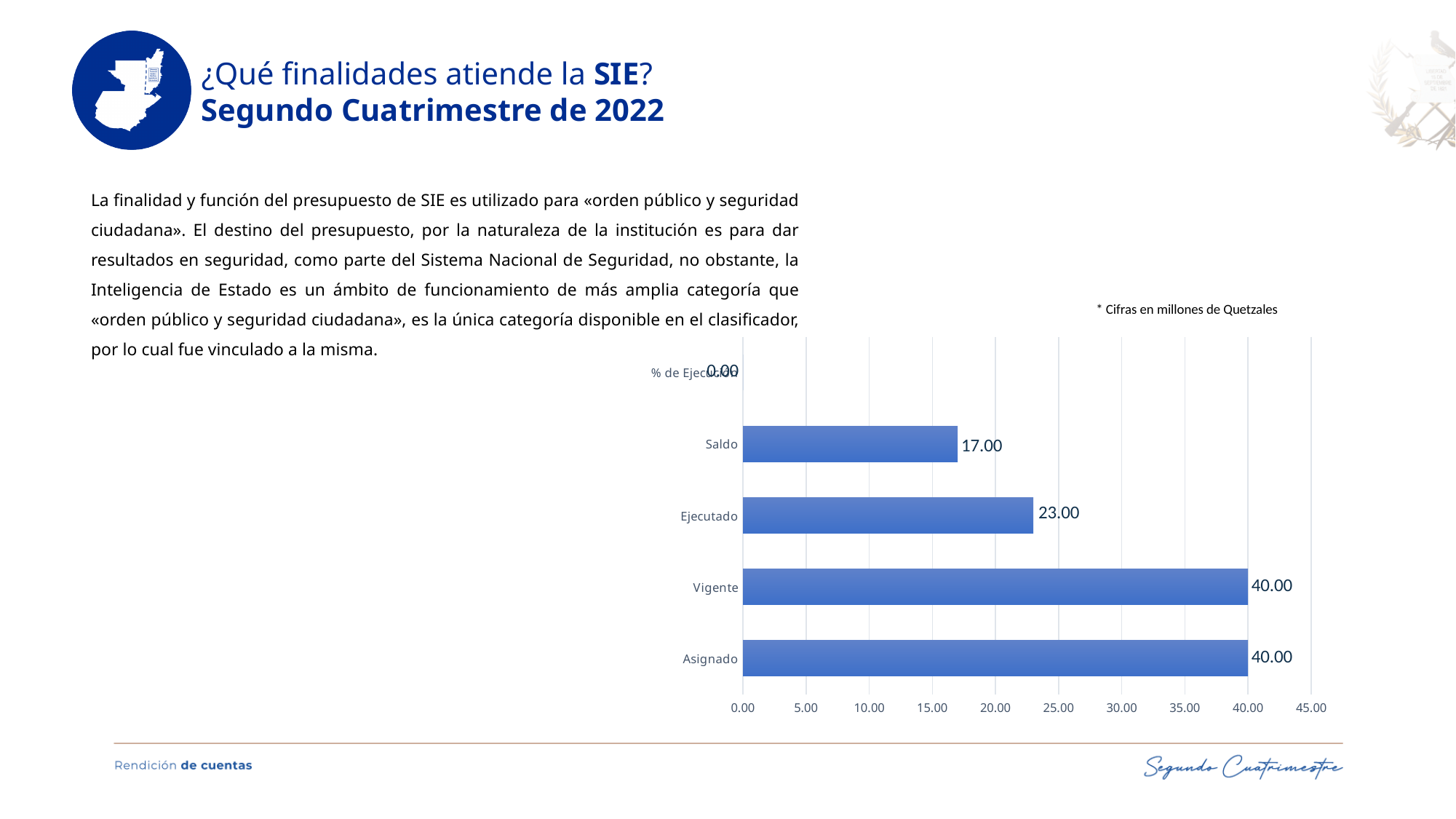
What is the value for Ejecutado? 23.00 What kind of chart is shown on the slide? Bar chart According to the note above the chart, in what units are the figures expressed? Millones de Quetzales What is the value for Saldo? 17.00 How many categories are shown in the chart? 5 What is the value for Asignado? 40.00 Which category has the lowest value? % de Ejecución What is the difference between the values for Vigente and Ejecutado? 17.00 What is the difference between the values for Ejecutado and Saldo? 6.00 What is the value shown for % de Ejecución? 0.00 What is the value for Vigente? 40.00 Which is larger, the value for Ejecutado or the value for Saldo? Ejecutado